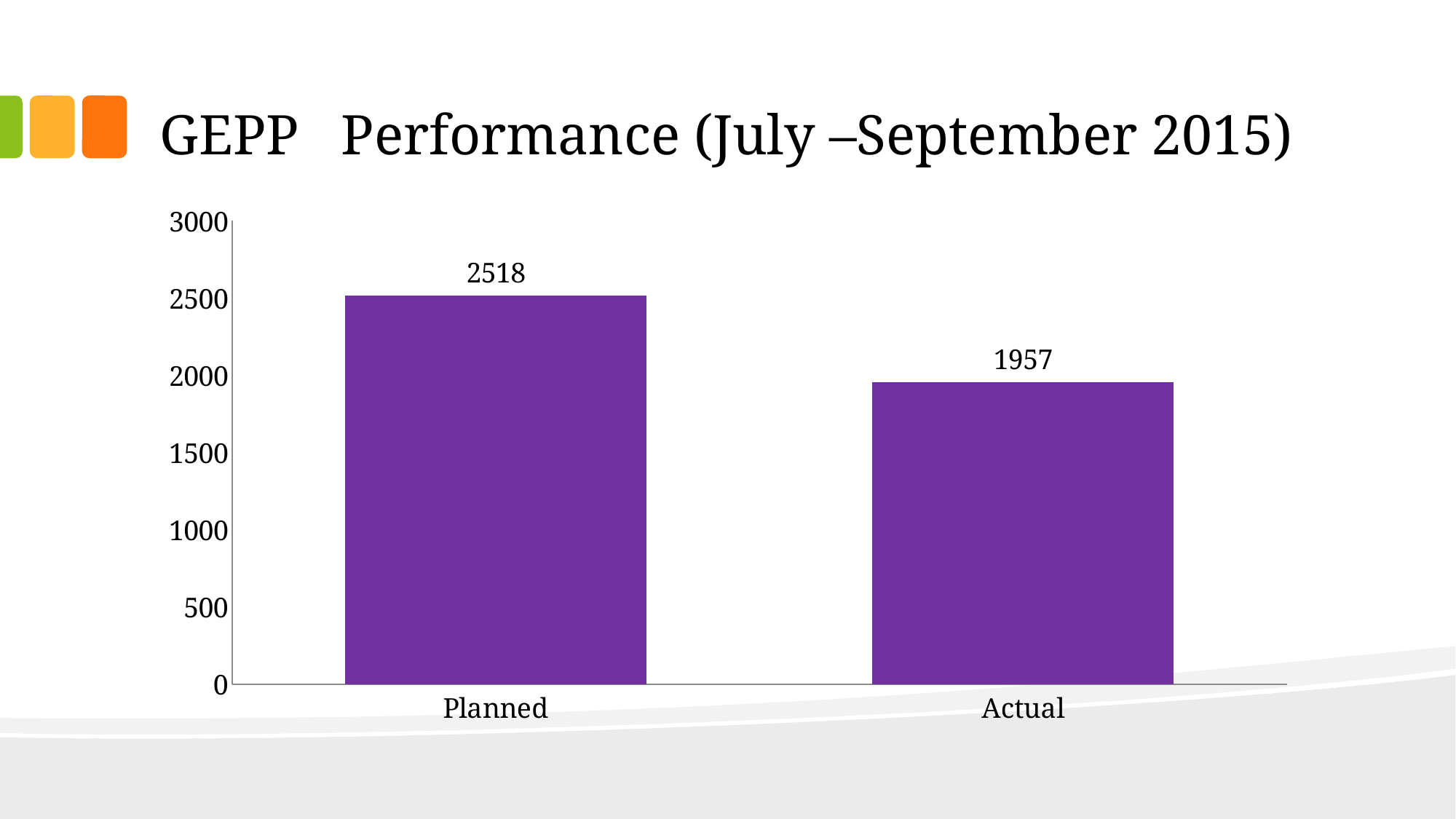
What is the difference between the Planned and Actual values? 561 What is the value for Actual? 1957 Do the values rise or fall from Planned to Actual? fall What is the title of the slide containing the chart? GEPP Performance (July –September 2015) Which category has the highest value? Planned Which is larger, the value for Planned or the value for Actual? Planned Which category has the lowest value? Actual What kind of chart is shown on the slide? bar chart What is the value for Planned? 2518 How many categories are shown on the x axis? 2 Is the value for Actual greater or less than 2000? less Is the value for Planned greater or less than 2500? greater